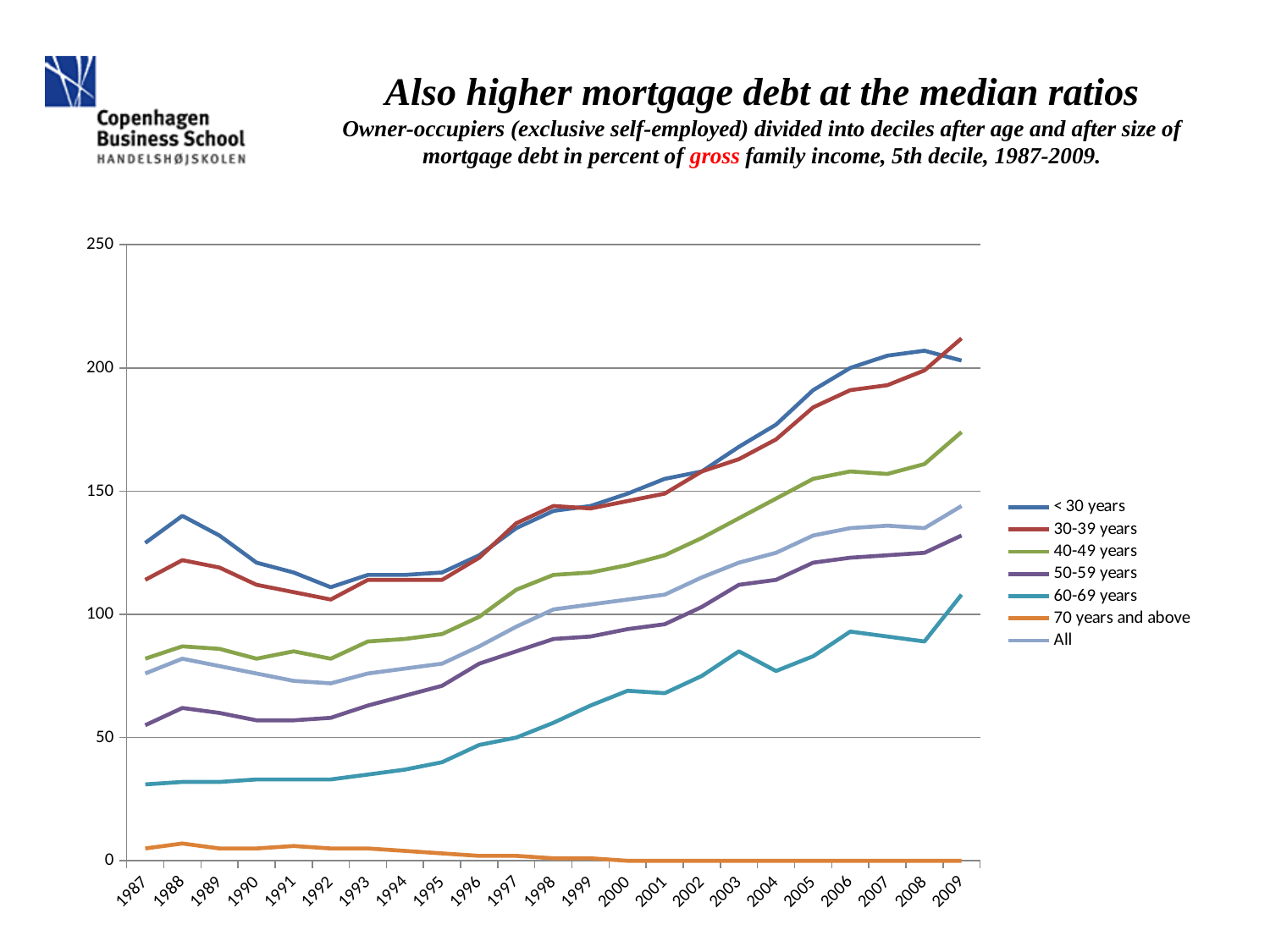
Is the value for < 30 years in 2009 greater or less than 200? greater Which series is drawn in orange in the legend? 70 years and above Which series has the highest value in 2009? 30-39 years Does the 60-69 years series generally rise or fall from 1987 to 2009? rise How many years are plotted along the x axis? 23 What kind of chart is shown on the slide? line chart In 2009, which is larger: the value for 40-49 years or the value for 50-59 years? 40-49 years Which series has the highest value in 1987? < 30 years Is the value for 60-69 years in 1987 greater or less than 50? less How many series does the legend list? 7 Which series has the lowest value in 2009? 70 years and above Is the value for 40-49 years in 2009 greater or less than 150? greater